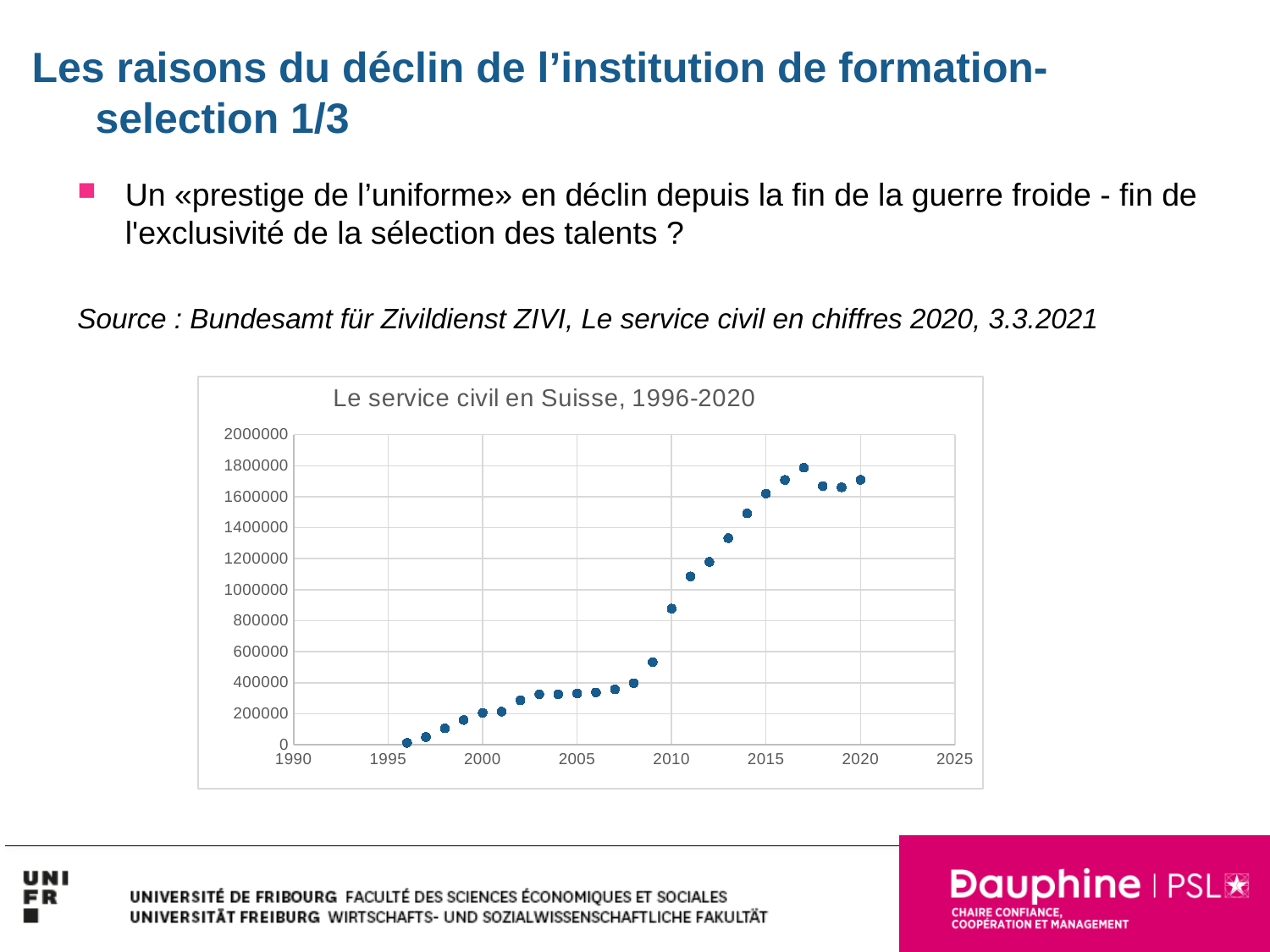
Is the value for 1996 greater or less than 200000? less Which year has the highest value in the chart? 2017 Is the value for 2010 greater or less than 1000000? less Which is larger, the value for 2009 or the value for 2010? 2010 How many data points are plotted in the chart? 25 What is the highest value shown on the vertical axis? 2000000 What is the title of the chart? Le service civil en Suisse, 1996-2020 Which year has the lowest value in the chart? 1996 Do the values generally rise or fall from 1996 to 2020? rise Is the value for 2017 greater or less than 1600000? greater What kind of chart is shown on the slide? scatter chart